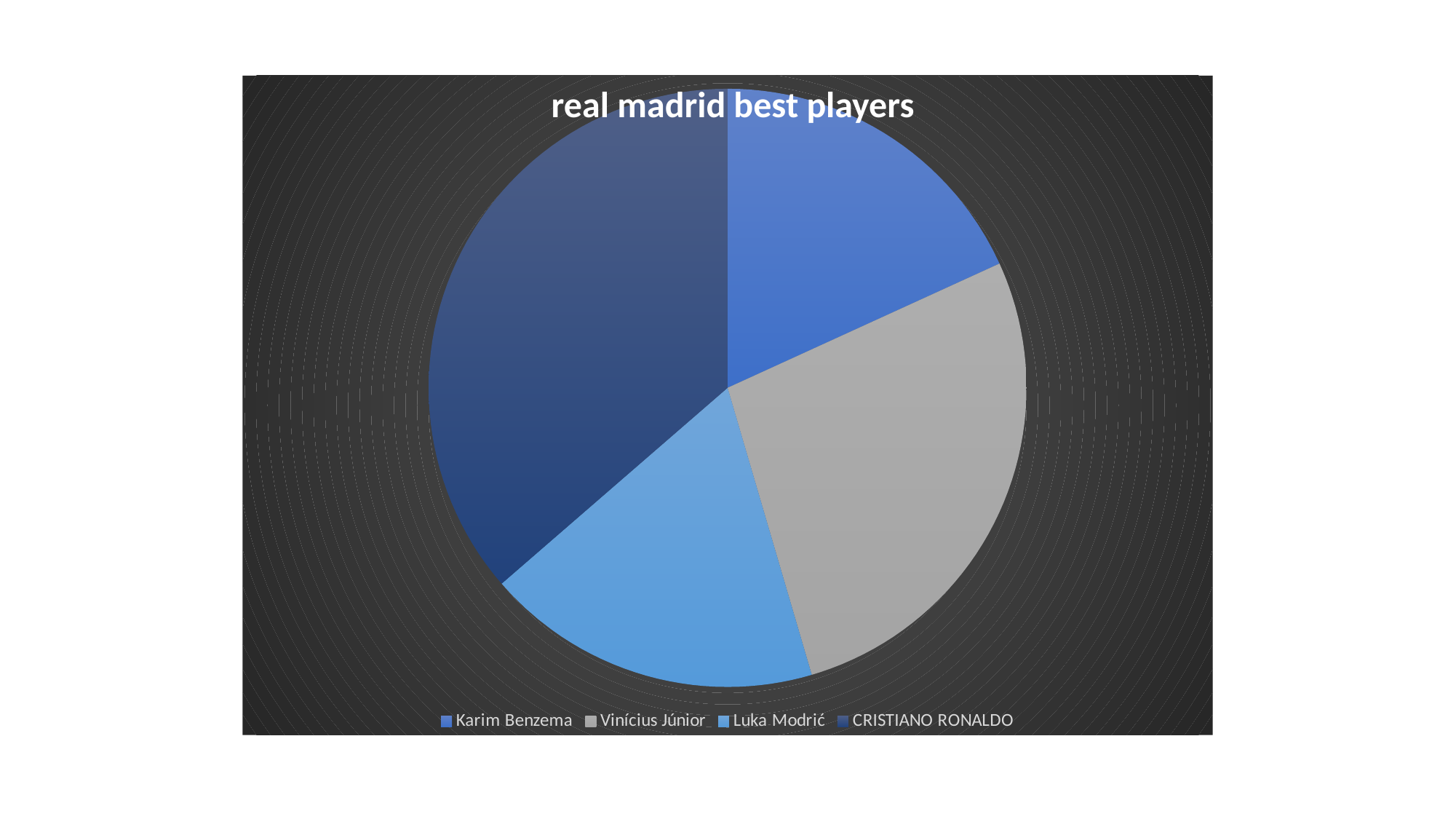
Which slice is larger, Vinícius Júnior or Karim Benzema? Vinícius Júnior Which player is represented by the grey slice? Vinícius Júnior What is the title of the chart? real madrid best players Which slice is larger, CRISTIANO RONALDO or Luka Modrić? CRISTIANO RONALDO Which slice is larger, CRISTIANO RONALDO or Vinícius Júnior? CRISTIANO RONALDO Which player has the largest slice of the pie? CRISTIANO RONALDO How many players (slices) does the pie chart show? 4 What kind of chart is shown on the slide? pie chart How many entries does the legend list? 4 Which player is listed first in the legend? Karim Benzema